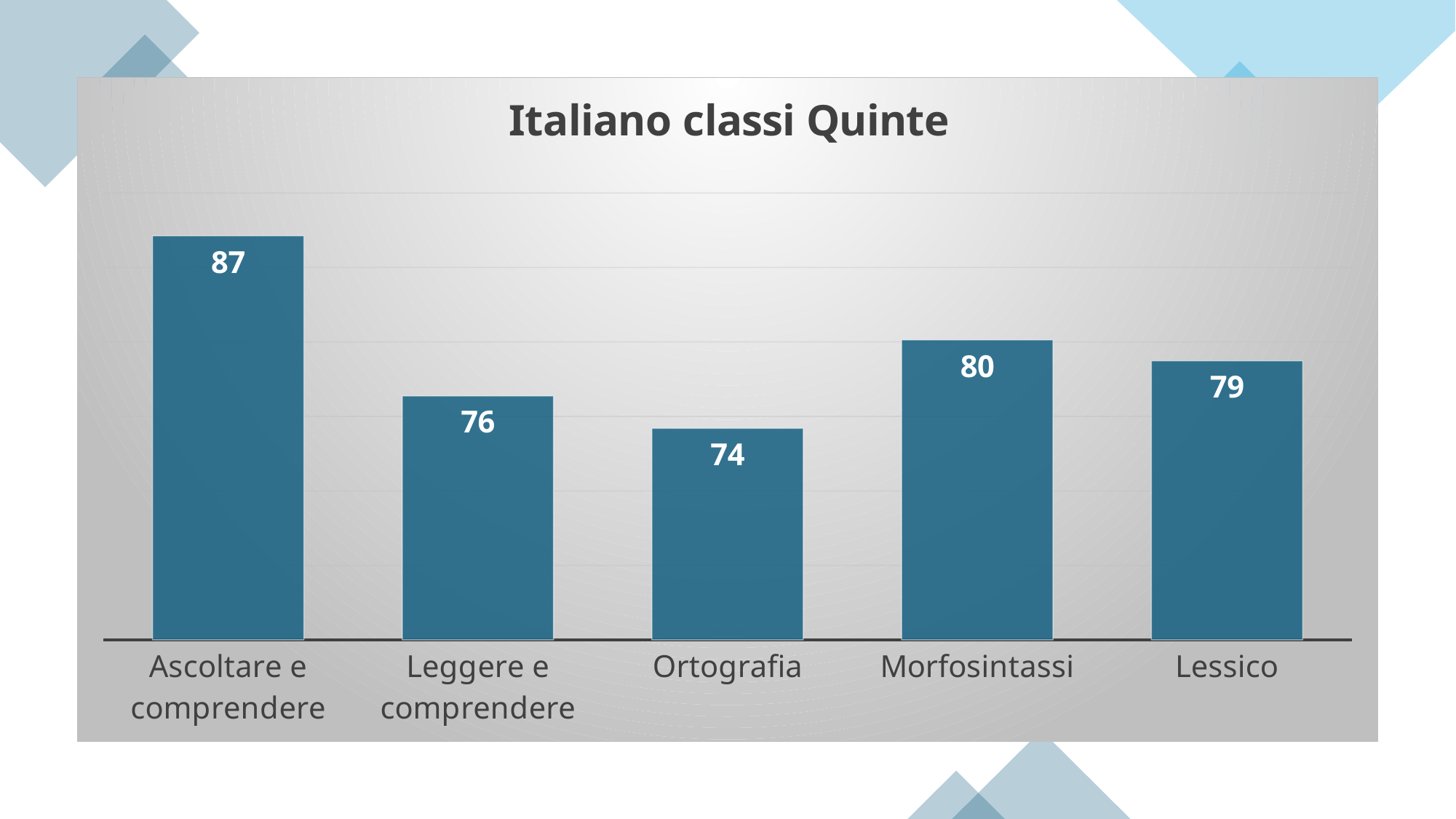
Which is larger, the value for Morfosintassi or the value for Leggere e comprendere? Morfosintassi What is the title of the chart? Italiano classi Quinte Which category has the highest value? Ascoltare e comprendere What is the value for Lessico? 79 What is the value for Ortografia? 74 Which category has the lowest value? Ortografia What is the difference between the values for Ascoltare e comprendere and Ortografia? 13 What kind of chart is shown on the slide? Bar chart How many categories are shown in the chart? 5 What is the value for Morfosintassi? 80 What is the value for Ascoltare e comprendere? 87 What is the value for Leggere e comprendere? 76